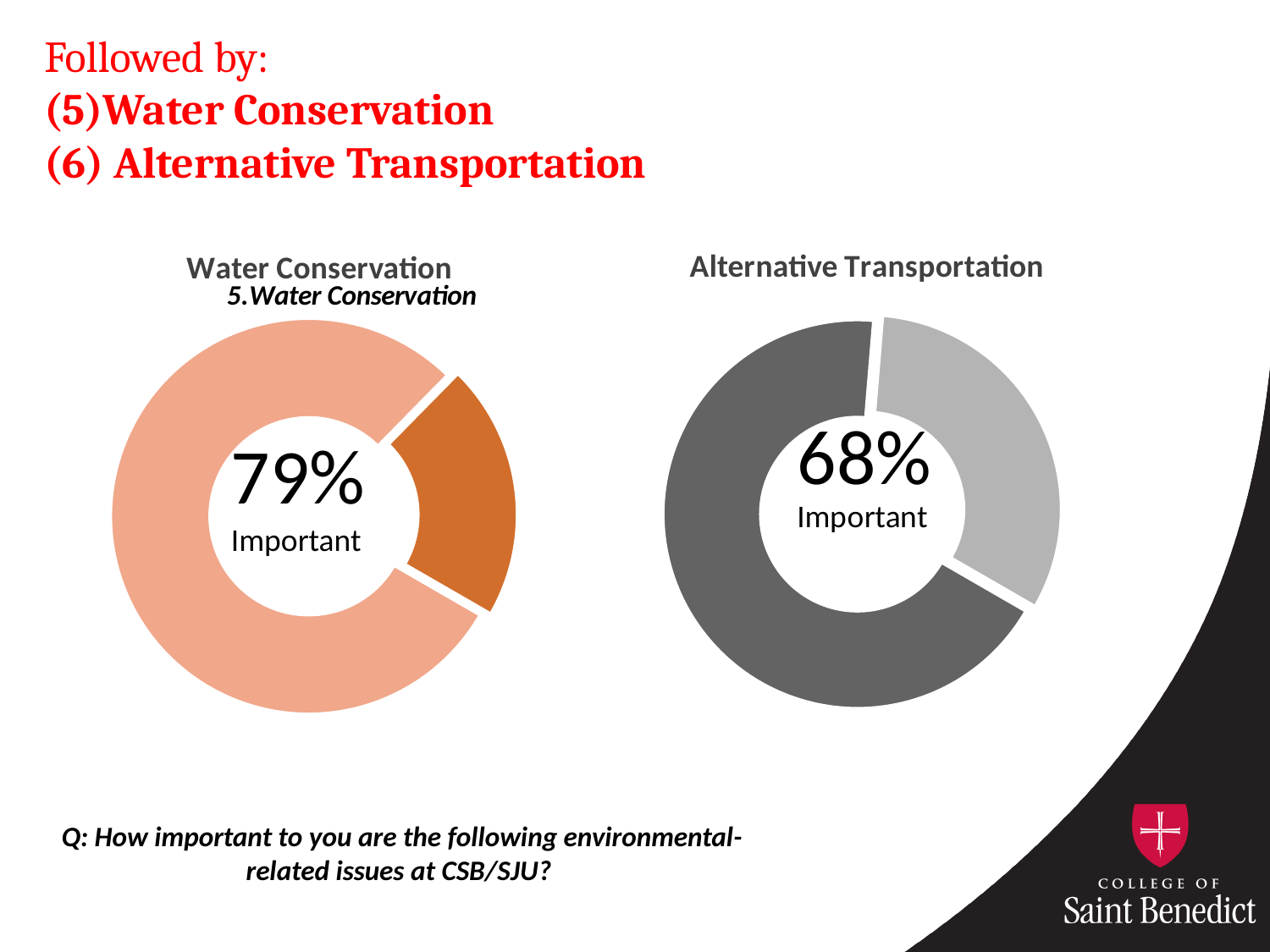
In the Alternative Transportation chart, what share of the donut does the large dark-grey slice represent? 68% Which issue has the higher 'Important' percentage, Water Conservation or Alternative Transportation? Water Conservation How many slices does the Alternative Transportation donut chart have? 2 In the Alternative Transportation chart, what percentage of respondents rated the issue as important? 68% How many slices does the Water Conservation donut chart have? 2 What kind of chart is used for Water Conservation? Donut (pie) chart In the Water Conservation chart, what percentage of respondents rated the issue as important? 79% What is the title of the chart on the left side of the slide? Water Conservation In the Water Conservation chart, what share of the donut does the large light-orange slice represent? 79% What is the title of the chart on the right side of the slide? Alternative Transportation What is the difference in percentage points between the 'Important' share for Water Conservation and for Alternative Transportation? 11 percentage points What kind of chart is used for Alternative Transportation? Donut (pie) chart